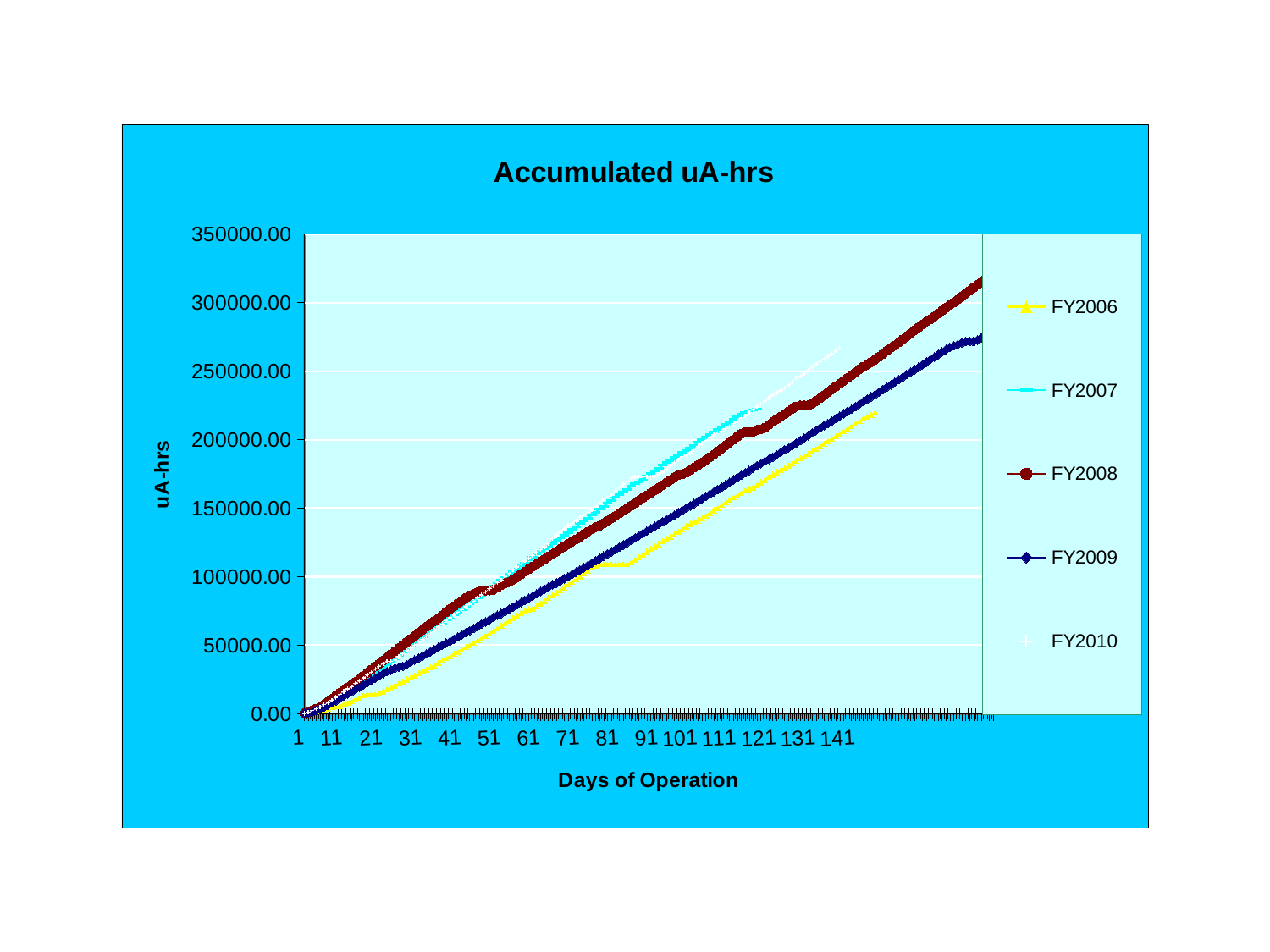
What kind of chart is shown on the slide? line chart Which series reaches the highest accumulated uA-hrs value on the chart? FY2008 What is the label of the x axis? Days of Operation Is the final value for FY2008 greater or less than 300000.00? greater Do the values for FY2008 rise or fall as the days of operation increase? rise Is the value for FY2008 at day 51 greater or less than 100000.00? less Is the final value for FY2006 greater or less than 200000.00? greater What is the title of the chart? Accumulated uA-hrs At day 101, which series is higher, FY2008 or FY2006? FY2008 How many series does the legend list? 5 At the end of the plotted data, which series is higher, FY2008 or FY2009? FY2008